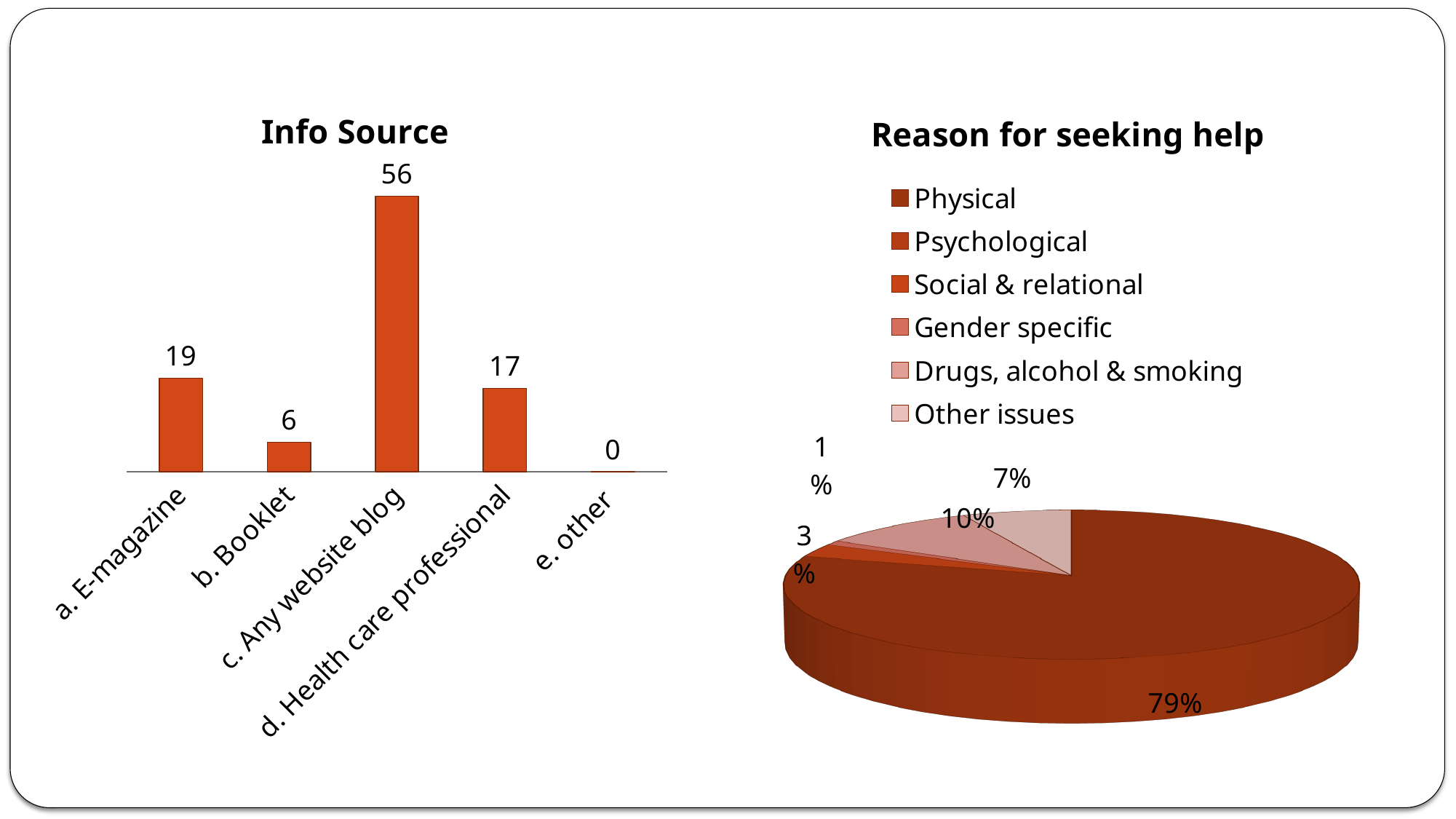
In the Info Source chart, what is the value for a. E-magazine? 19 In the Info Source chart, what is the value for d. Health care professional? 17 In the Reason for seeking help chart, what share of the pie is the largest slice? 79% What kind of chart is the Reason for seeking help chart? pie chart What kind of chart is the Info Source chart? bar chart In the Info Source chart, which is larger: the value for b. Booklet or d. Health care professional? d. Health care professional In the Info Source chart, which category has the lowest value? e. other In the Info Source chart, what is the difference between the values for c. Any website blog and a. E-magazine? 37 How many entries does the legend of the Reason for seeking help chart list? 6 How many categories are shown in the Info Source chart? 5 In the Info Source chart, what is the value for c. Any website blog? 56 In the Info Source chart, which category has the highest value? c. Any website blog